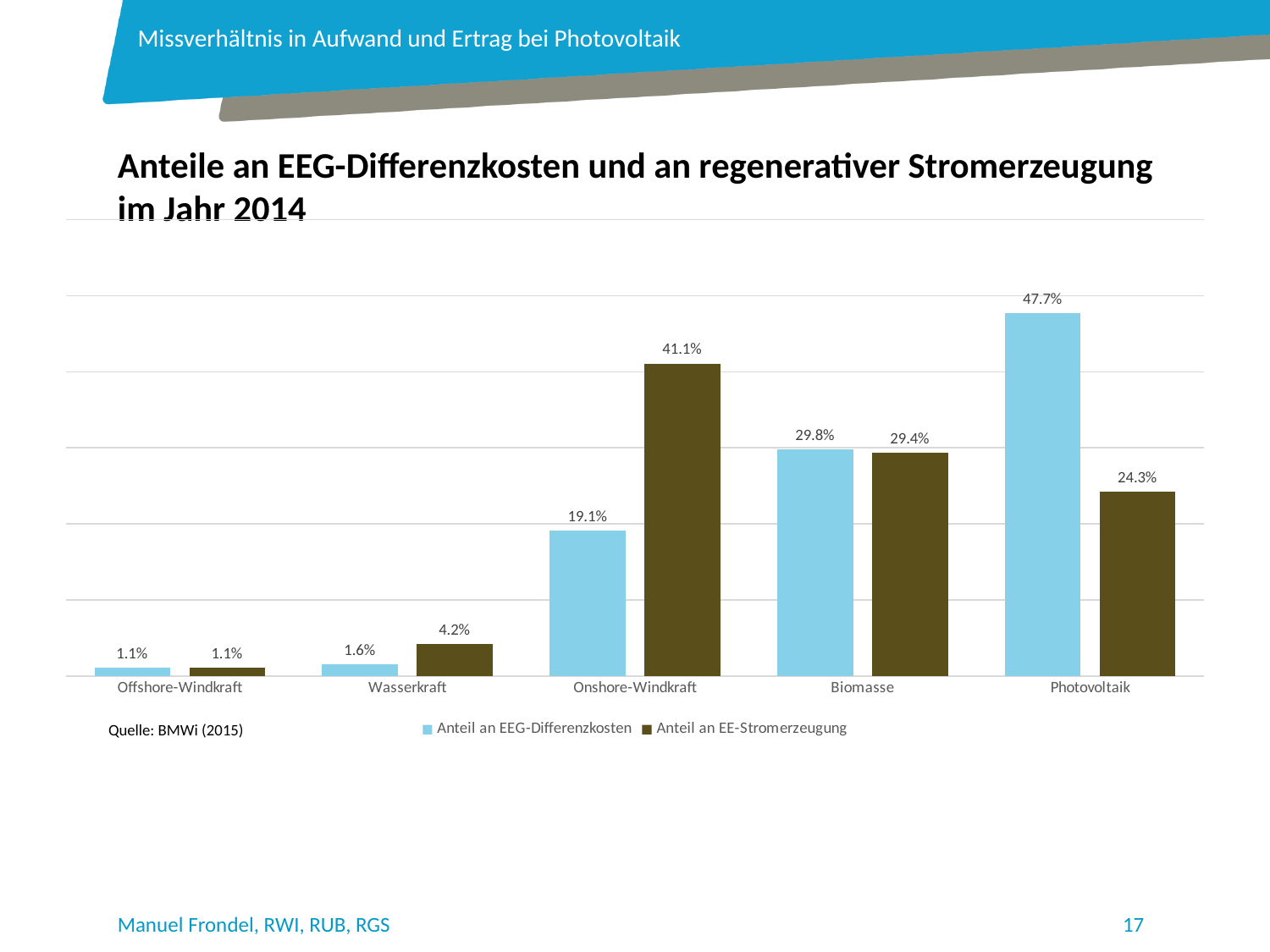
What is the value of Anteil an EE-Stromerzeugung for Onshore-Windkraft? 41.1% Which category has the lowest Anteil an EE-Stromerzeugung? Offshore-Windkraft How many categories are shown on the x axis? 5 What source is cited below the chart? BMWi (2015) What is the difference between Anteil an EEG-Differenzkosten and Anteil an EE-Stromerzeugung for Photovoltaik? 23.4% Which category has the highest Anteil an EEG-Differenzkosten? Photovoltaik What is the difference between Anteil an EEG-Differenzkosten and Anteil an EE-Stromerzeugung for Biomasse? 0.4% What is the value of Anteil an EE-Stromerzeugung for Wasserkraft? 4.2% What kind of chart is shown on the slide? Bar chart How many series does the legend list? 2 For Onshore-Windkraft, which is larger: Anteil an EEG-Differenzkosten or Anteil an EE-Stromerzeugung? Anteil an EE-Stromerzeugung What is the value of Anteil an EEG-Differenzkosten for Photovoltaik? 47.7%